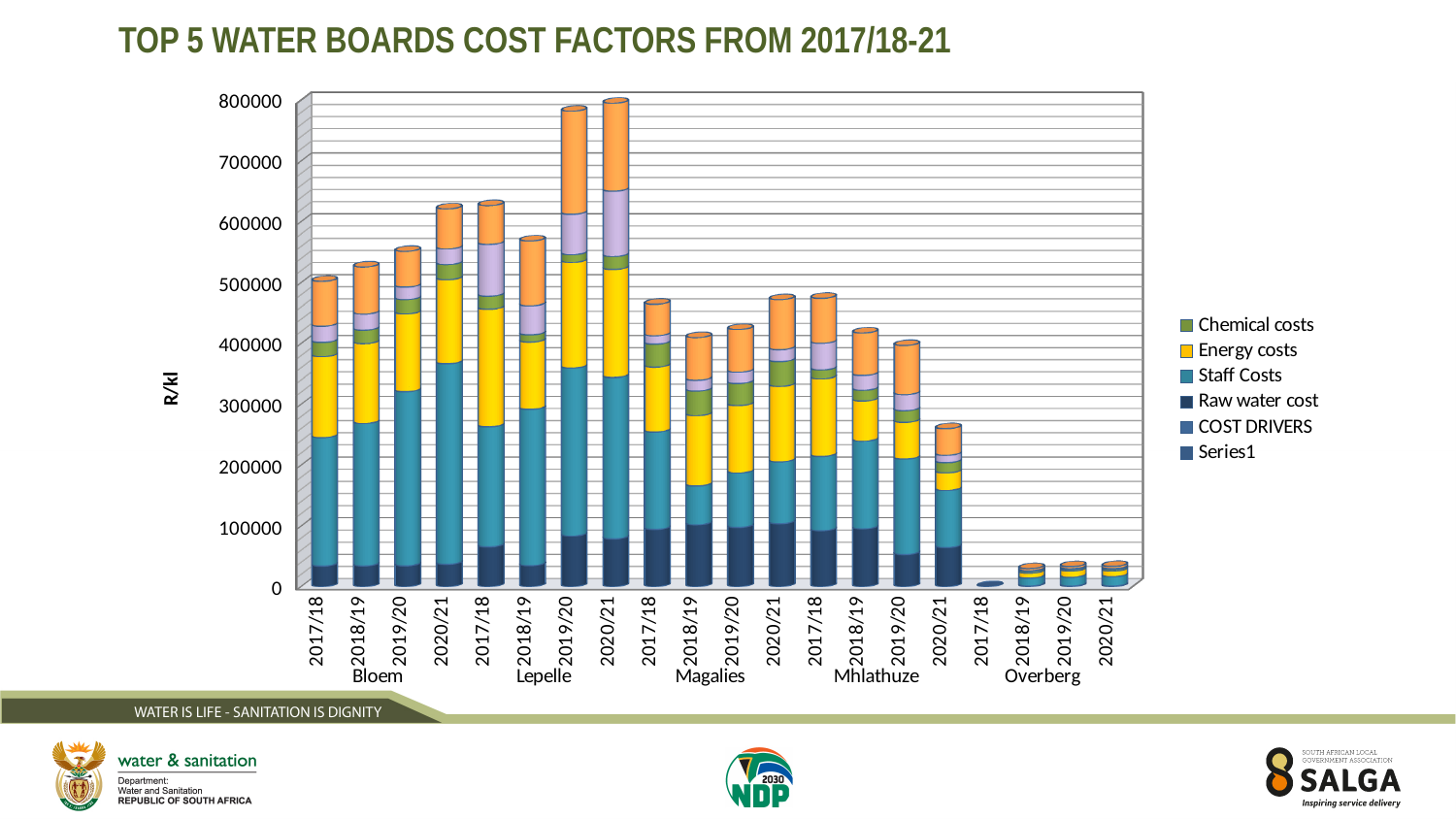
How many entries does the legend list? 6 Which water board has the tallest stacked bar in the chart? Lepelle What kind of chart is shown on the slide? Stacked bar chart Is the total for Overberg in 2018/19 greater or less than 100000? less What is the label on the y axis? R/kl How many water boards are shown along the x axis? 5 Do the Bloem totals rise or fall from 2017/18 to 2020/21? rise Is the total for Mhlathuze in 2020/21 greater or less than 300000? less Which water board has the lowest bars overall? Overberg Which is larger, the total for Mhlathuze in 2019/20 or in 2020/21? 2019/20 Is the total for Lepelle in 2019/20 greater or less than 700000? greater